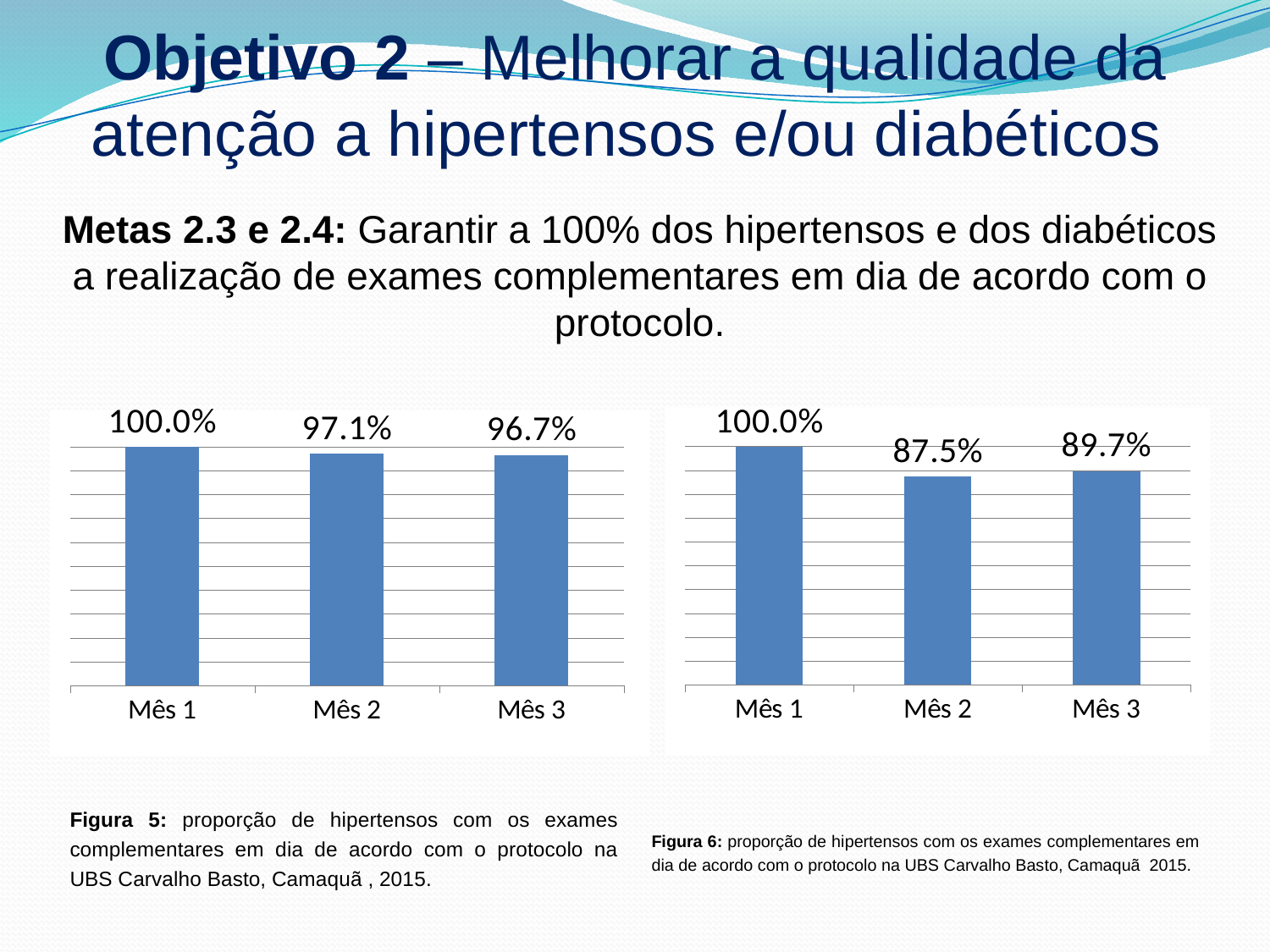
In the right chart (Figura 6), which month has the highest value? Mês 1 In the right chart (Figura 6), what is the difference between the values for Mês 1 and Mês 2? 12.5% In the left chart (Figura 5), what is the difference between the values for Mês 2 and Mês 3? 0.4% In the right chart (Figura 6), which is larger, the value for Mês 2 or Mês 3? Mês 3 In the left chart (Figura 5), what is the value for Mês 3? 96.7% What kind of chart is the right chart (Figura 6)? Bar chart In the left chart (Figura 5), which month has the lowest value? Mês 3 In the left chart (Figura 5), what is the value for Mês 2? 97.1% How many bars are plotted in the left chart (Figura 5)? 3 In the right chart (Figura 6), which month has the lowest value? Mês 2 In the right chart (Figura 6), what is the value for Mês 3? 89.7% In the right chart (Figura 6), what is the value for Mês 2? 87.5%